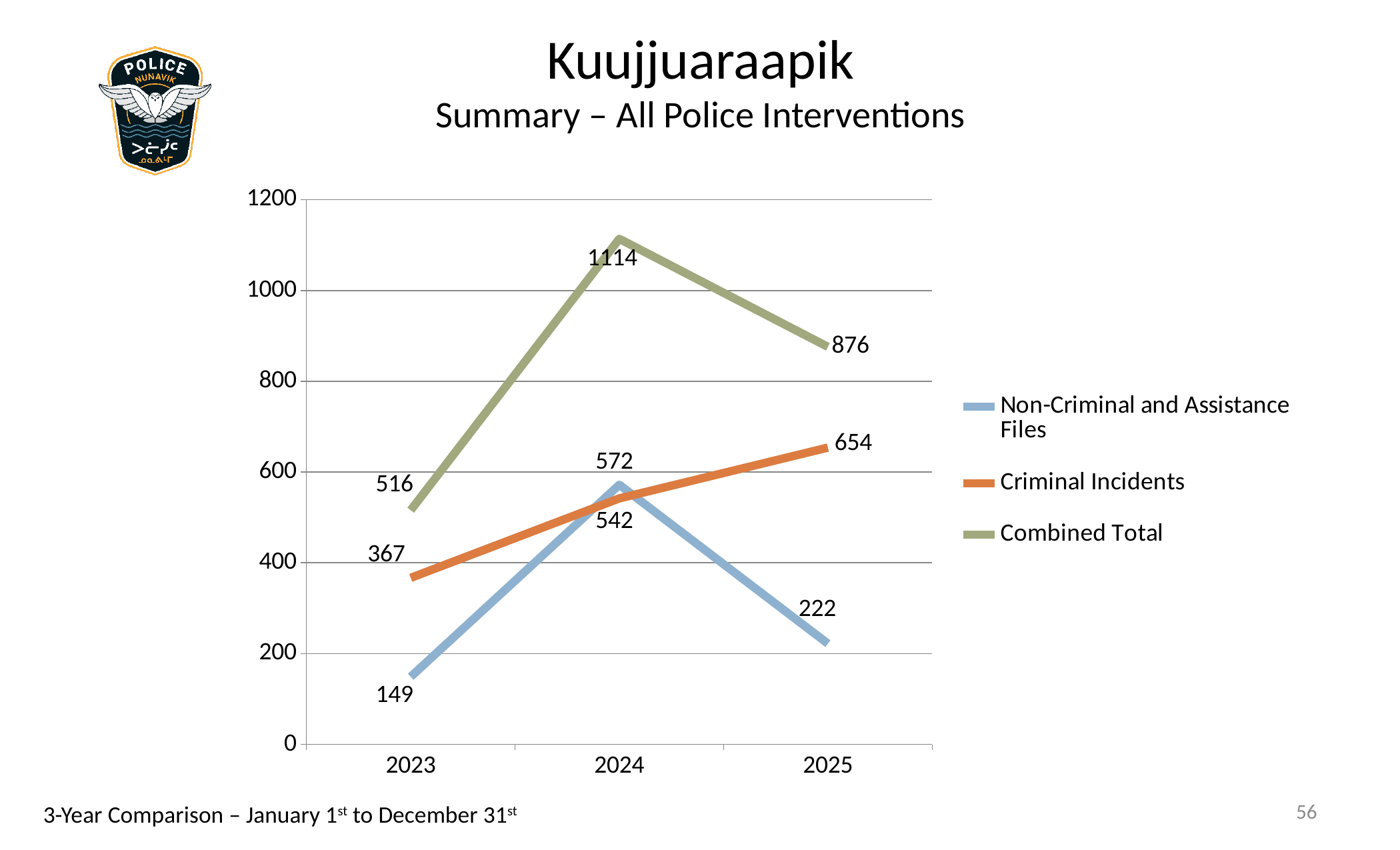
What is the value for Non-Criminal and Assistance Files in 2023? 149 What kind of chart is shown on the slide? line chart In which year is the Combined Total highest? 2024 Do the Criminal Incidents values rise or fall from 2023 to 2025? rise What is the value for Criminal Incidents in 2025? 654 How many years are shown on the x axis? 3 Which is larger in 2024: Non-Criminal and Assistance Files or Criminal Incidents? Non-Criminal and Assistance Files In which year is the Non-Criminal and Assistance Files value lowest? 2023 How many series does the legend list? 3 Is the Combined Total for 2023 greater or less than 600? less What is the Combined Total for 2024? 1114 What is the difference between the Combined Total in 2024 and in 2025? 238